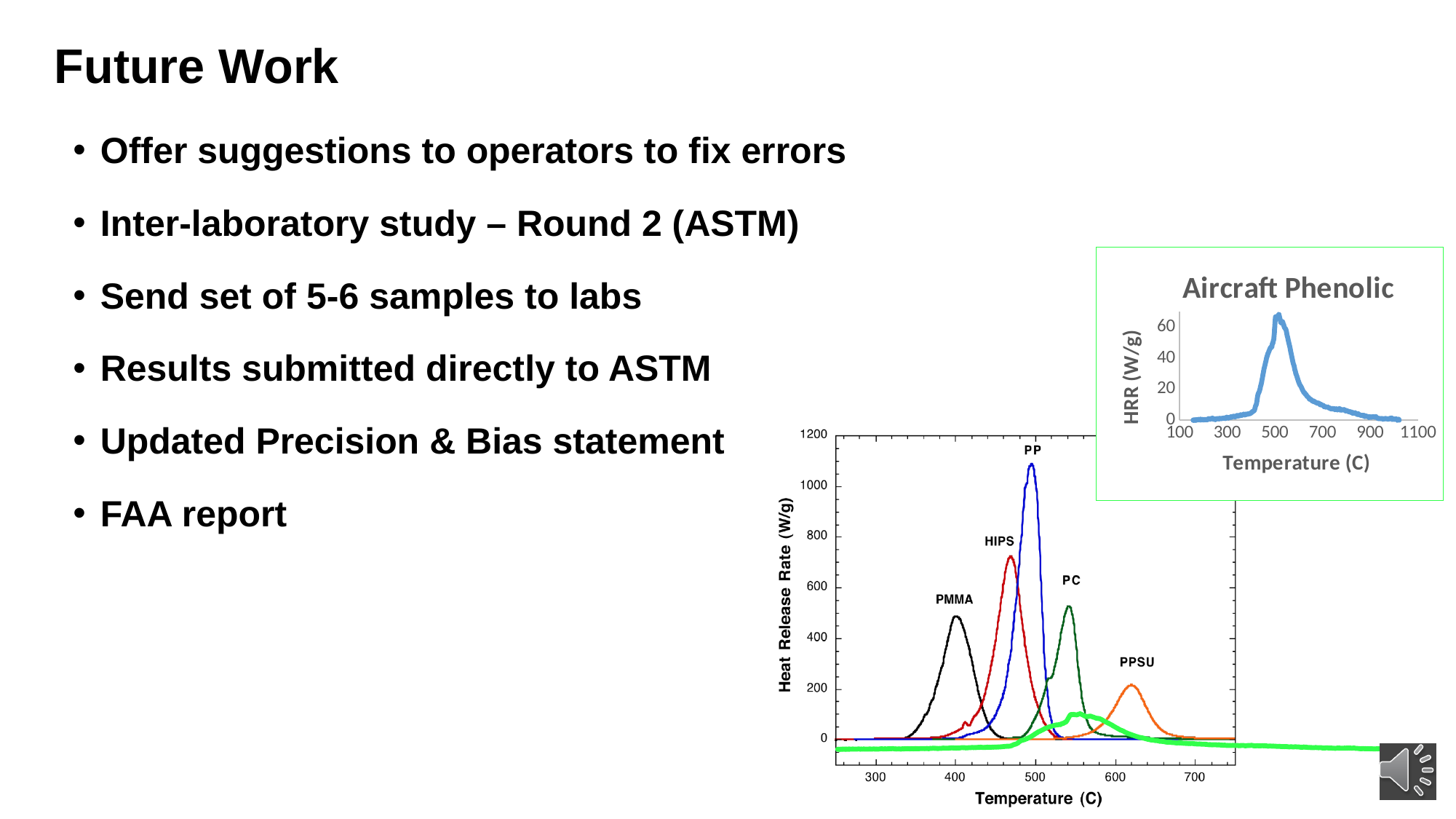
In the large bottom-right chart, which labeled material has the highest peak heat release rate? PP In the large bottom-right chart, is the peak value for PP greater or less than 1000? greater What is the y-axis label of the Aircraft Phenolic chart? HRR (W/g) In the large bottom-right chart, which has a higher peak heat release rate, HIPS or PC? HIPS How many labeled material curves are shown in the large bottom-right chart? 5 In the large bottom-right chart, is the peak value for PPSU greater or less than 400? less In the large bottom-right chart, is the peak value for PMMA greater or less than 600? less What kind of chart is the large chart at the bottom right of the slide? line chart In the large bottom-right chart, which labeled material has the lowest peak heat release rate? PPSU What is the title of the small chart at the top right of the slide? Aircraft Phenolic What kind of chart is the Aircraft Phenolic chart? line chart